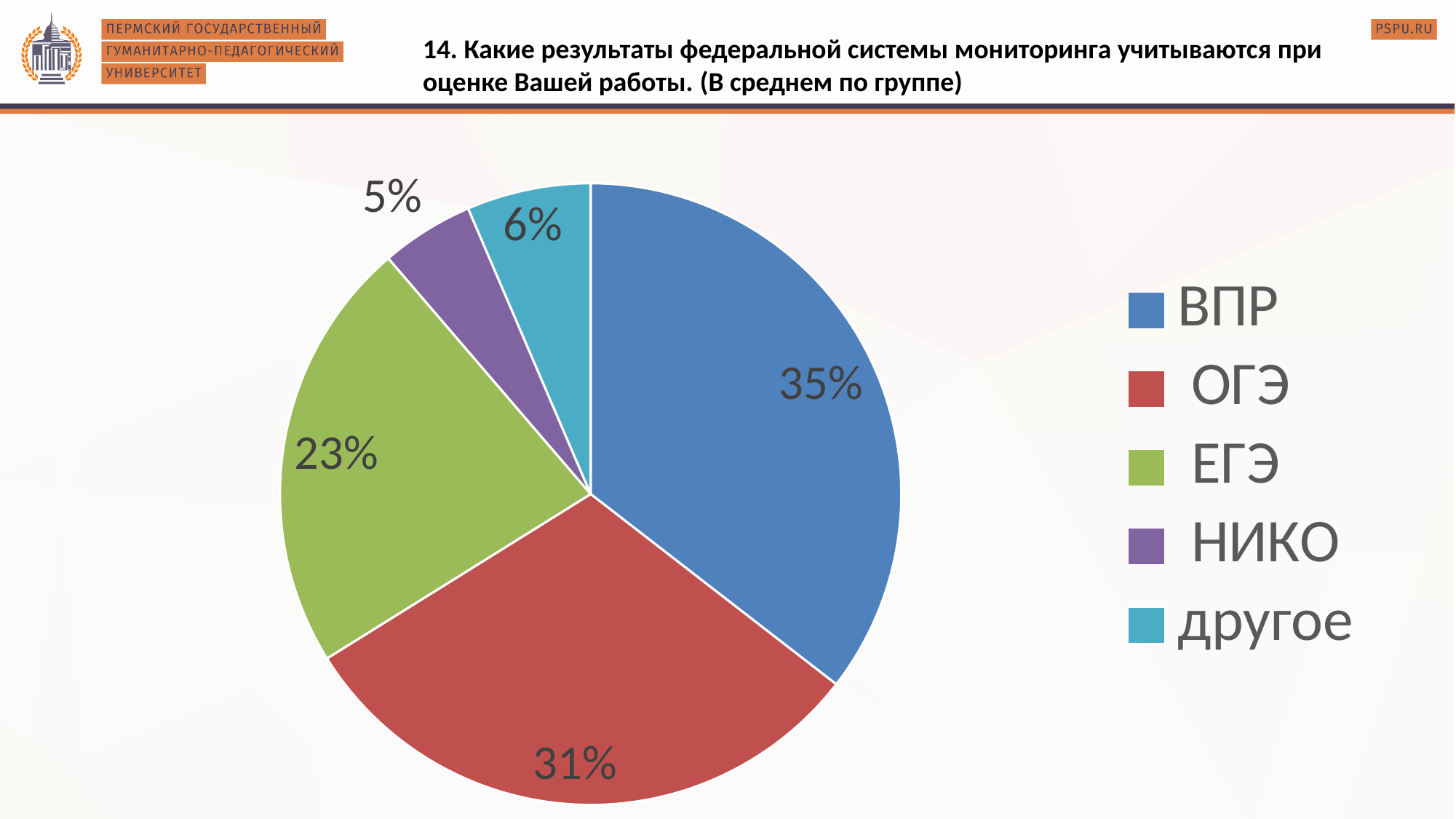
Which category has the largest slice of the pie? ВПР What share of the pie does НИКО have? 5% What is the difference in percentage points between ВПР and ЕГЭ? 12 What colour is the slice for ЕГЭ? green Which is larger, the share for ОГЭ or the share for ЕГЭ? ОГЭ What share of the pie does ЕГЭ have? 23% What share of the pie does ВПР have? 35% What kind of chart is shown on the slide? pie chart How many categories does the pie chart show? 5 Which category has the smallest slice of the pie? НИКО